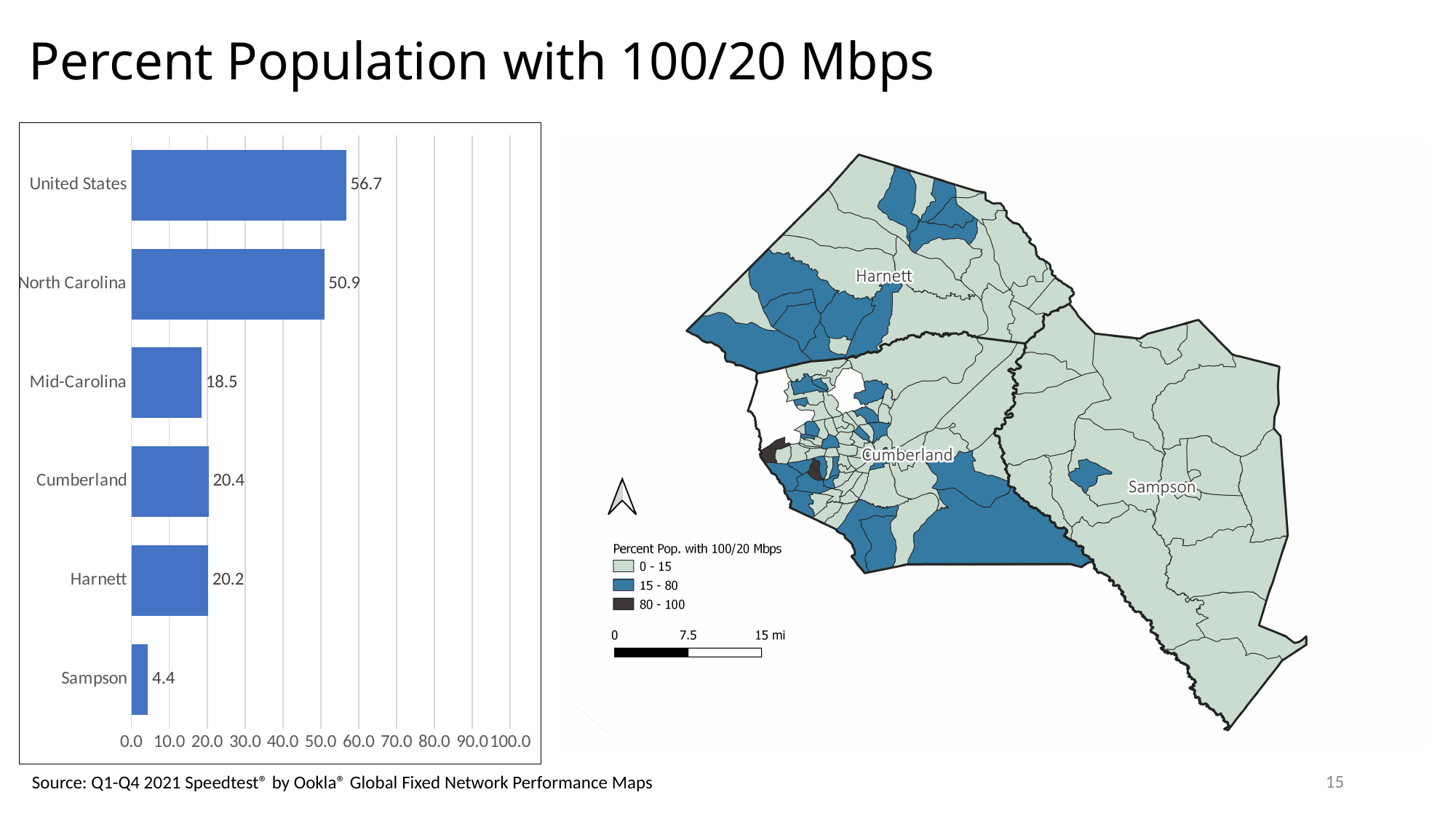
What is the value for Sampson in the bar chart? 4.4 What is the difference between the values for United States and North Carolina in the bar chart? 5.8 Which category has the highest value in the bar chart? United States What kind of chart is shown on the left of the slide? Bar chart How many categories are shown in the bar chart? 6 What is the value for North Carolina in the bar chart? 50.9 What is the maximum value shown on the x axis of the bar chart? 100.0 What is the value for United States in the bar chart? 56.7 Which category has the lowest value in the bar chart? Sampson What is the value for Mid-Carolina in the bar chart? 18.5 Which has a larger value in the bar chart, Cumberland or Mid-Carolina? Cumberland What is the difference between the values for Cumberland and Sampson in the bar chart? 16.0